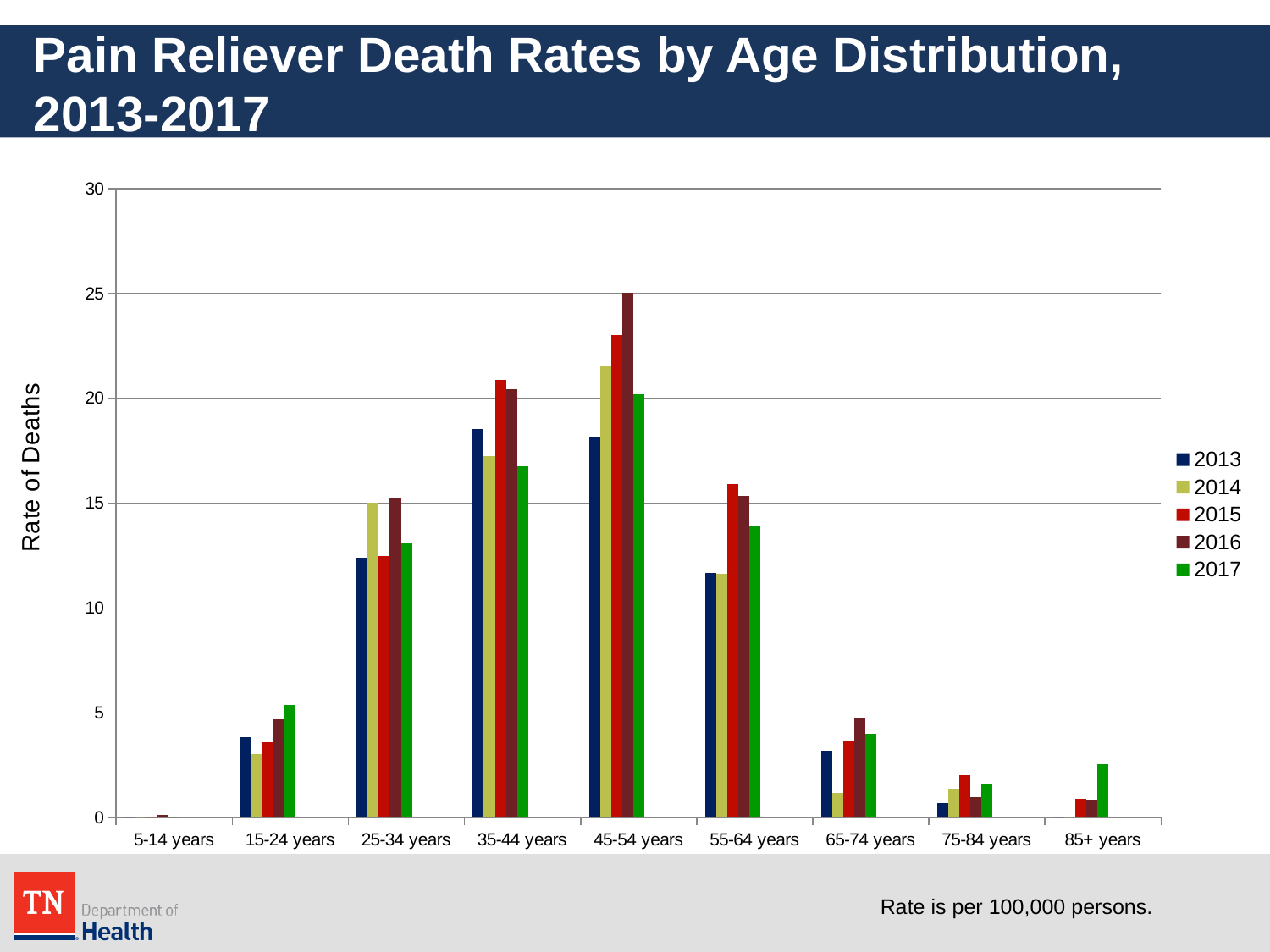
What kind of chart is shown on the slide? bar chart Is the 2017 value for 85+ years greater or less than 5? less In the 15-24 years age group, which is larger, the 2017 value or the 2013 value? 2017 How many series does the legend list? 5 How many age groups are shown on the x axis? 9 Is the 2016 value for 45-54 years greater or less than 20? greater In the 55-64 years age group, which is larger, the 2015 value or the 2014 value? 2015 Is the 2013 value for 25-34 years greater or less than 15? less What is the title of the y axis? Rate of Deaths Which age group has the highest death rate for 2016? 45-54 years Which year has the lowest death rate in the 65-74 years age group? 2014 Which year has the highest death rate in the 45-54 years age group? 2016